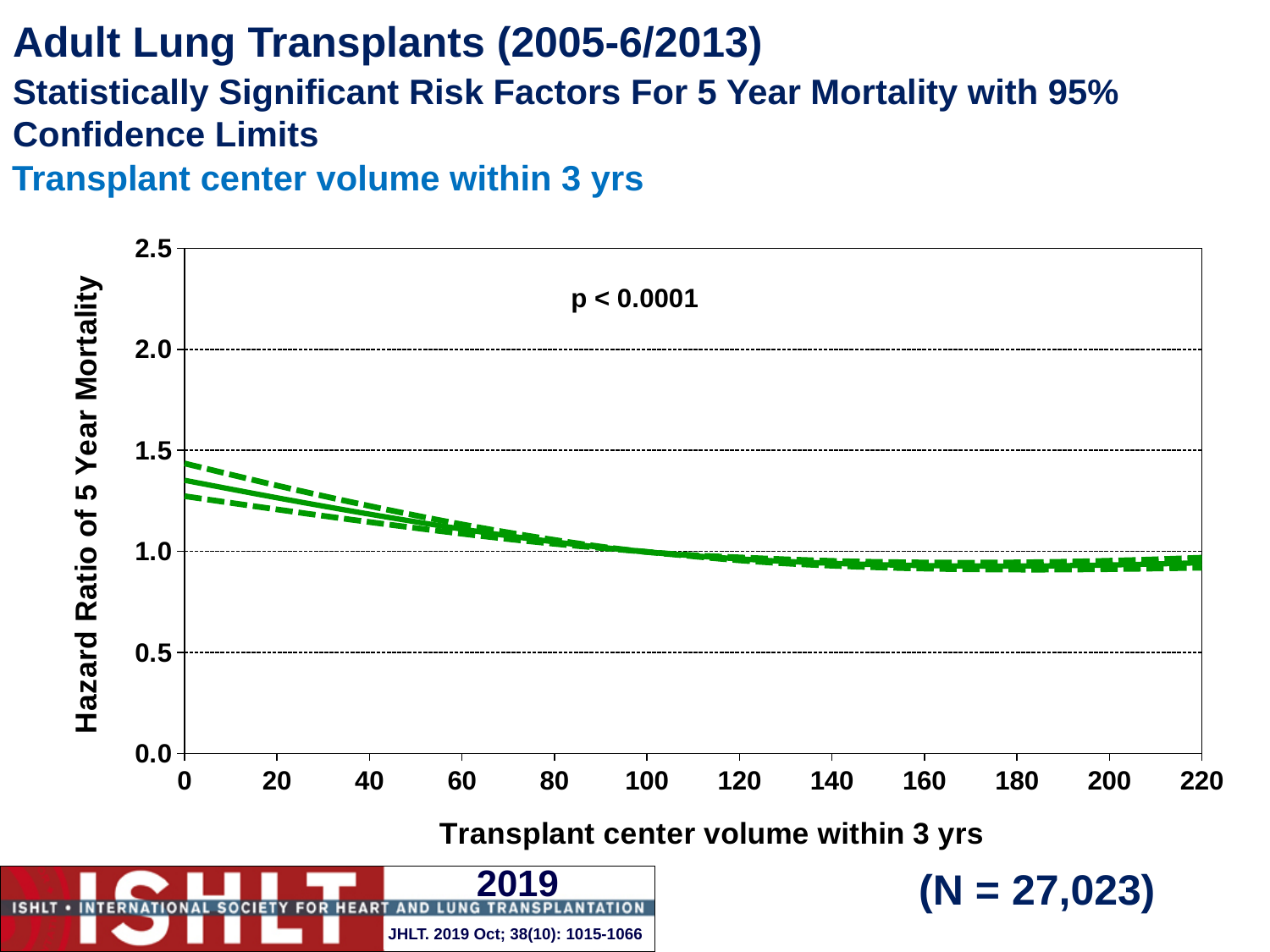
Is the hazard ratio of 5 year mortality at a transplant center volume of 0 greater or less than 1.0? greater Is the hazard ratio of 5 year mortality at a transplant center volume of 160 greater or less than 0.5? greater What is the sample size (N) shown on the slide? N = 27,023 Is the hazard ratio of 5 year mortality at a transplant center volume of 20 greater or less than 2.0? less Does the hazard ratio of 5 year mortality rise or fall as transplant center volume within 3 yrs increases from 0 to 140? fall What kind of chart is shown on the slide? line chart What p-value is printed on the chart? p < 0.0001 Which has the higher hazard ratio of 5 year mortality: a transplant center volume of 20 or a volume of 180? 20